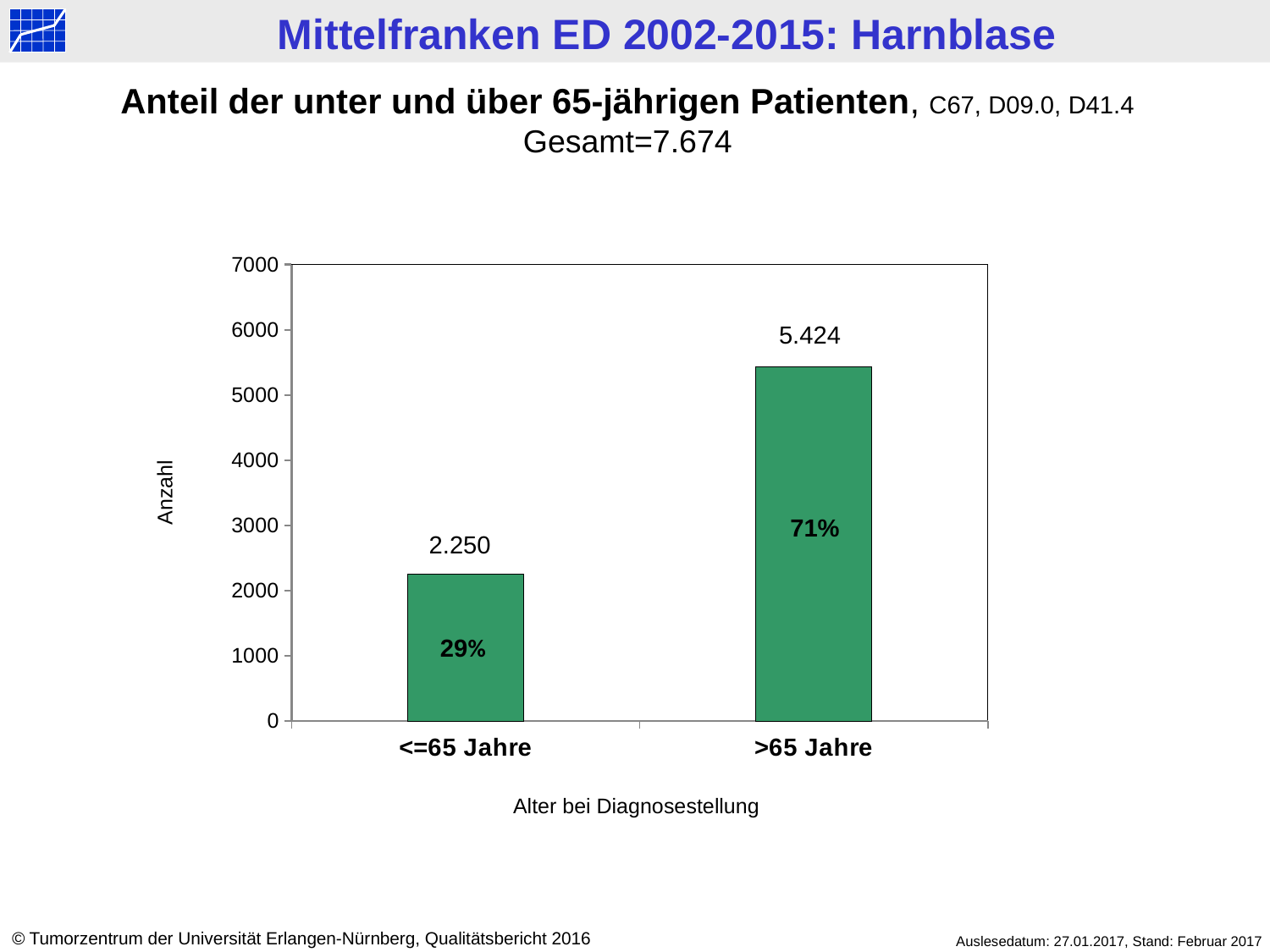
Which age category has the lowest number of patients? <=65 Jahre What percentage is shown on the bar for <=65 Jahre? 29% How many categories are shown on the x axis? 2 Is the value for >65 Jahre greater or less than 5000? greater What percentage is shown on the bar for >65 Jahre? 71% What is the difference in patient numbers between the >65 Jahre and <=65 Jahre categories? 3.174 What kind of chart is shown on the slide? bar chart What is the number of patients in the >65 Jahre category? 5.424 Is the value for <=65 Jahre greater or less than 3000? less What is the number of patients in the <=65 Jahre category? 2.250 Which age category has the highest number of patients? >65 Jahre What is the label of the x axis? Alter bei Diagnosestellung